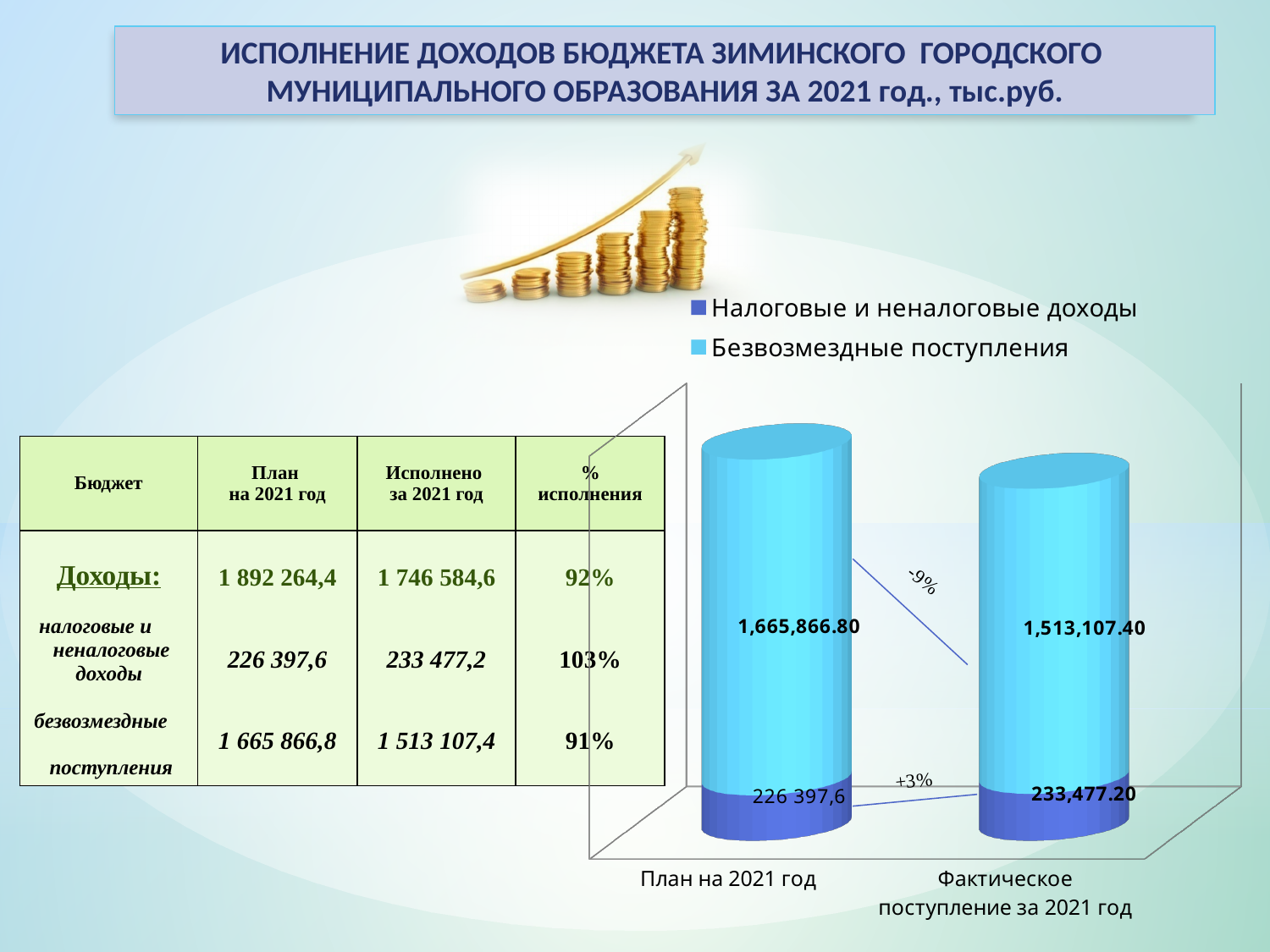
How many categories are shown on the x axis of the chart? 2 What is the value of Безвозмездные поступления for План на 2021 год? 1,665,866.80 What is the value of Безвозмездные поступления for Фактическое поступление за 2021 год? 1,513,107.40 Which category has the higher value for Безвозмездные поступления? План на 2021 год What is the value of Налоговые и неналоговые доходы for Фактическое поступление за 2021 год? 233,477.20 What is the value of Налоговые и неналоговые доходы for План на 2021 год? 226 397,6 By how much does Безвозмездные поступления for План на 2021 год exceed the value for Фактическое поступление за 2021 год? 152,759.40 How many series does the chart legend list? 2 Which series is shown in dark blue in the chart legend? Налоговые и неналоговые доходы What kind of chart is shown on the slide? bar chart What is the total of the stacked bar for План на 2021 год? 1,892,264.40 What is the difference between Налоговые и неналоговые доходы for Фактическое поступление за 2021 год and for План на 2021 год? 7,079.60